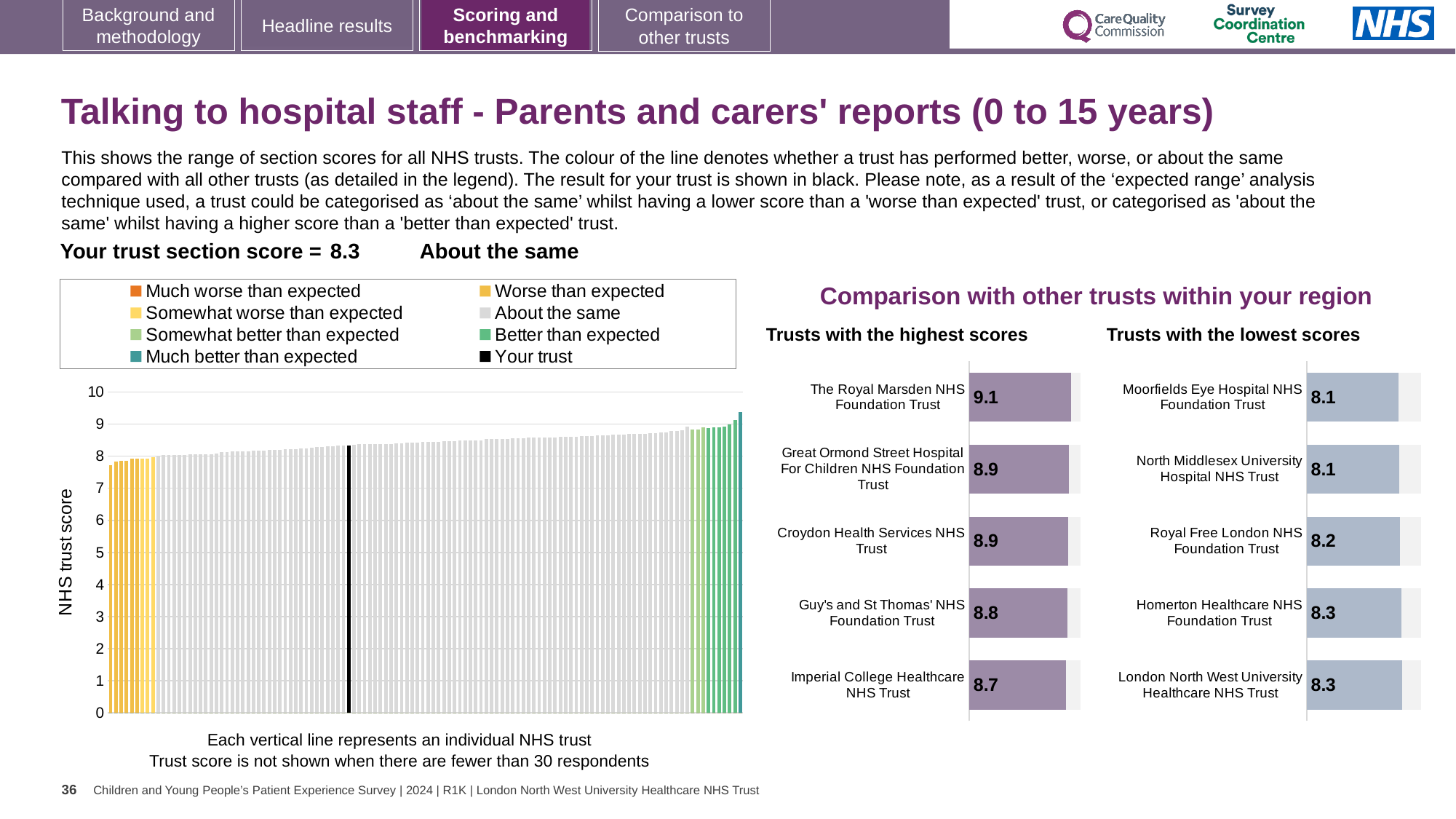
How many entries does the legend of the NHS trust score chart on the left list? 8 In the 'Trusts with the highest scores' chart, what is the difference between the scores of The Royal Marsden NHS Foundation Trust and Imperial College Healthcare NHS Trust? 0.4 What is the title of the section containing the two bar charts on the right of the slide? Comparison with other trusts within your region What kind of chart is the NHS trust score chart on the left of the slide? Bar chart In the 'Trusts with the highest scores' chart, which has the higher score: Croydon Health Services NHS Trust or Guy's and St Thomas' NHS Foundation Trust? Croydon Health Services NHS Trust In the 'Trusts with the highest scores' chart, what is the score for The Royal Marsden NHS Foundation Trust? 9.1 In the 'Trusts with the highest scores' chart, which trust has the highest score? The Royal Marsden NHS Foundation Trust In the 'Trusts with the lowest scores' chart, what is the score for Royal Free London NHS Foundation Trust? 8.2 How many trusts are shown in the 'Trusts with the lowest scores' chart? 5 In the 'Trusts with the lowest scores' chart, what is the difference between the scores of Homerton Healthcare NHS Foundation Trust and Moorfields Eye Hospital NHS Foundation Trust? 0.2 In the NHS trust score chart on the left, is the value for the black 'Your trust' bar greater or less than 5? greater In the 'Trusts with the highest scores' chart, what is the score for Imperial College Healthcare NHS Trust? 8.7